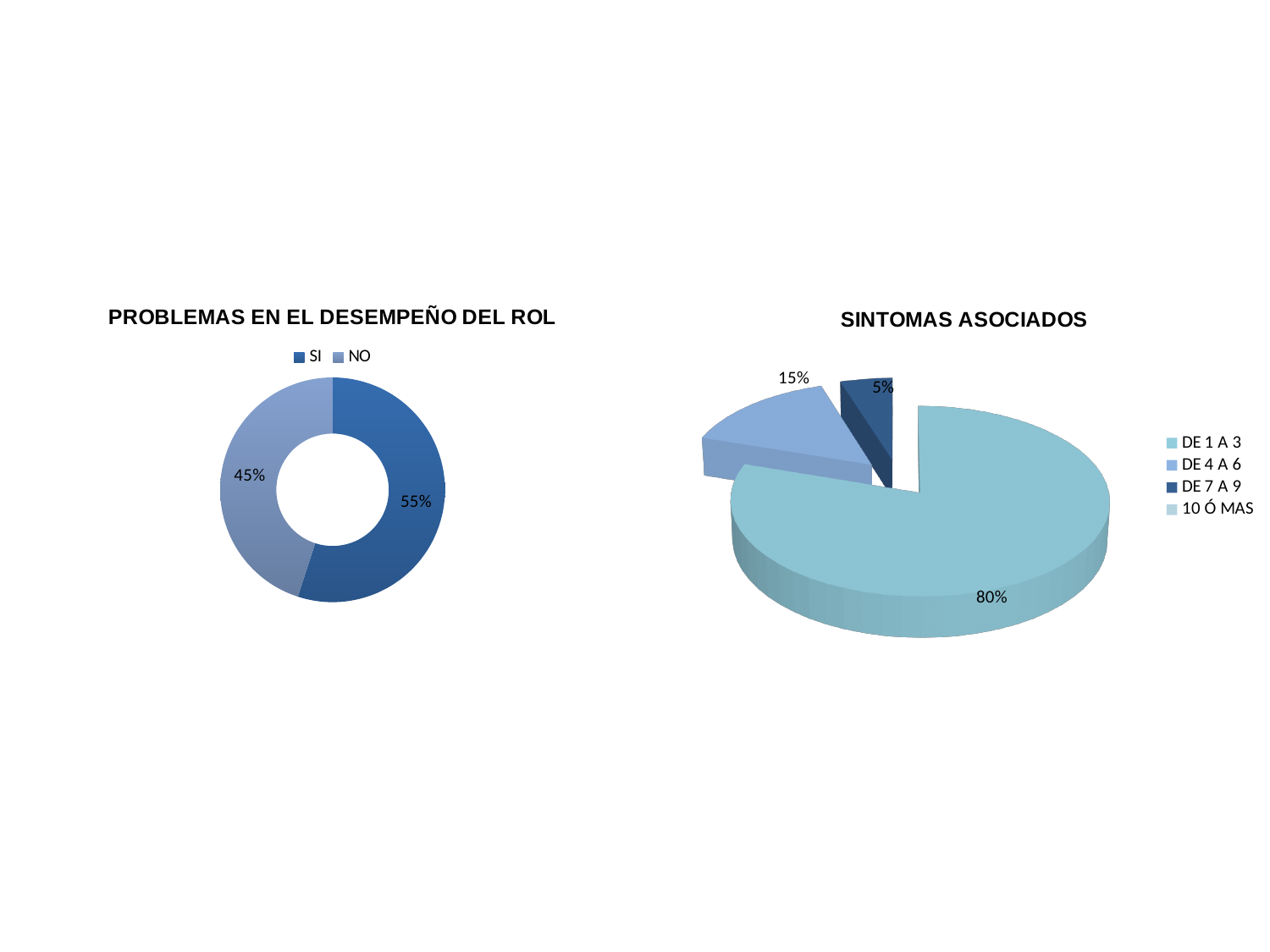
In the chart titled PROBLEMAS EN EL DESEMPEÑO DEL ROL, which category has the larger share, SI or NO? SI In the chart titled SINTOMAS ASOCIADOS, what percentage is shown for DE 4 A 6? 15% In the chart titled SINTOMAS ASOCIADOS, which category has the largest slice? DE 1 A 3 In the chart titled PROBLEMAS EN EL DESEMPEÑO DEL ROL, what is the difference in percentage points between SI and NO? 10 What kind of chart is the one titled PROBLEMAS EN EL DESEMPEÑO DEL ROL? Doughnut chart In the chart titled PROBLEMAS EN EL DESEMPEÑO DEL ROL, what percentage is shown for SI? 55% In the chart titled PROBLEMAS EN EL DESEMPEÑO DEL ROL, what percentage is shown for NO? 45% In the chart titled PROBLEMAS EN EL DESEMPEÑO DEL ROL, how many entries does the legend list? 2 In the chart titled SINTOMAS ASOCIADOS, what percentage is shown for DE 7 A 9? 5% What kind of chart is the one titled SINTOMAS ASOCIADOS? Pie chart In the chart titled SINTOMAS ASOCIADOS, how many entries does the legend list? 4 In the chart titled SINTOMAS ASOCIADOS, what percentage is shown for DE 1 A 3? 80%